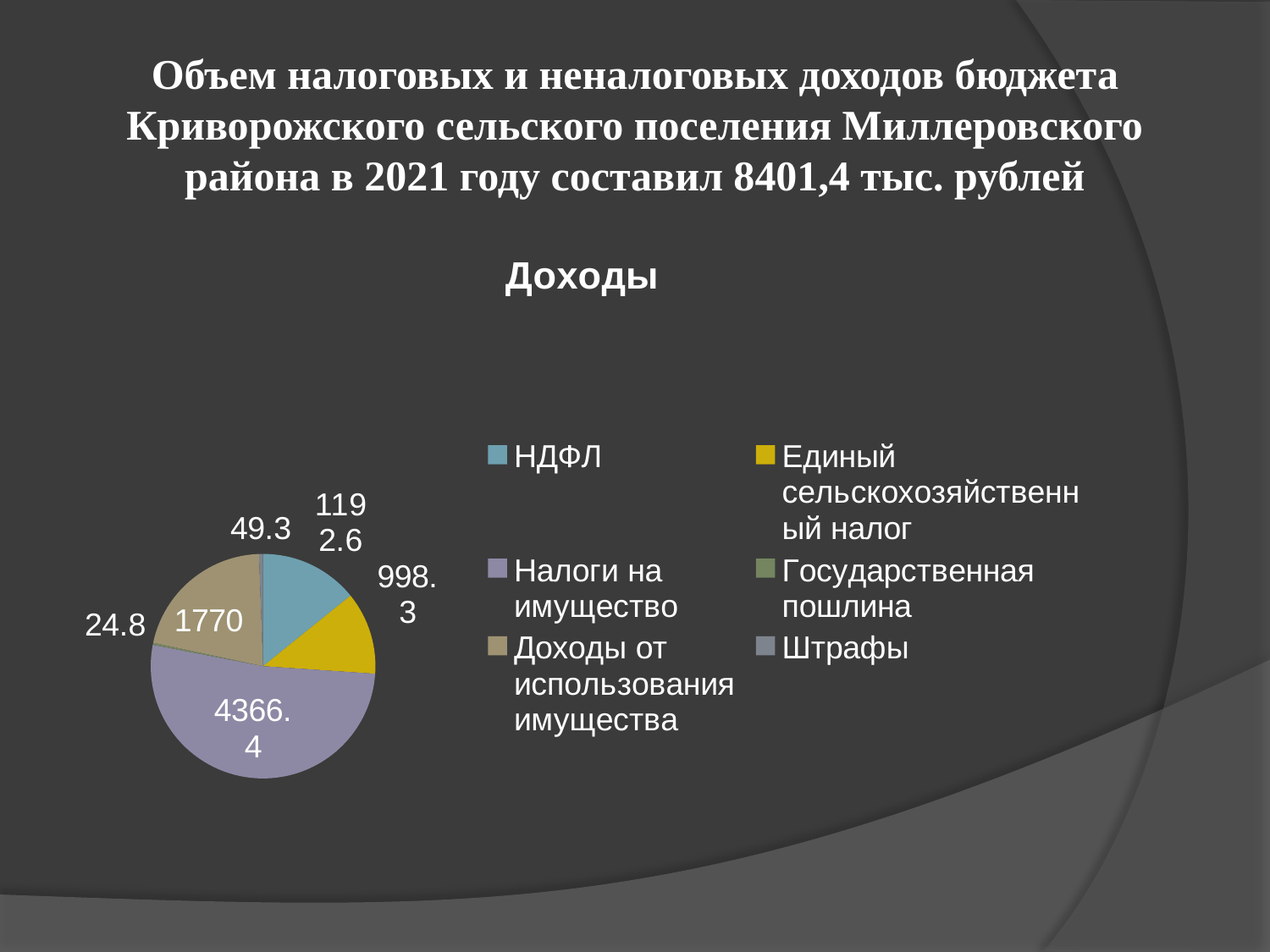
What is the title of the chart? Доходы Which category has the smallest slice of the pie? Государственная пошлина Which is larger, the value for НДФЛ or the value for Единый сельскохозяйственный налог? НДФЛ What is the difference between the values for Налоги на имущество and Доходы от использования имущества? 2596.4 What is the value for Единый сельскохозяйственный налог? 998.3 Which category has the largest slice of the pie? Налоги на имущество What is the value for Налоги на имущество? 4366.4 What colour is the slice for Налоги на имущество? Purple What is the value for НДФЛ? 1192.6 How many slices does the pie chart have? 6 What is the value for Доходы от использования имущества? 1770 What type of chart is shown on the slide? Pie chart